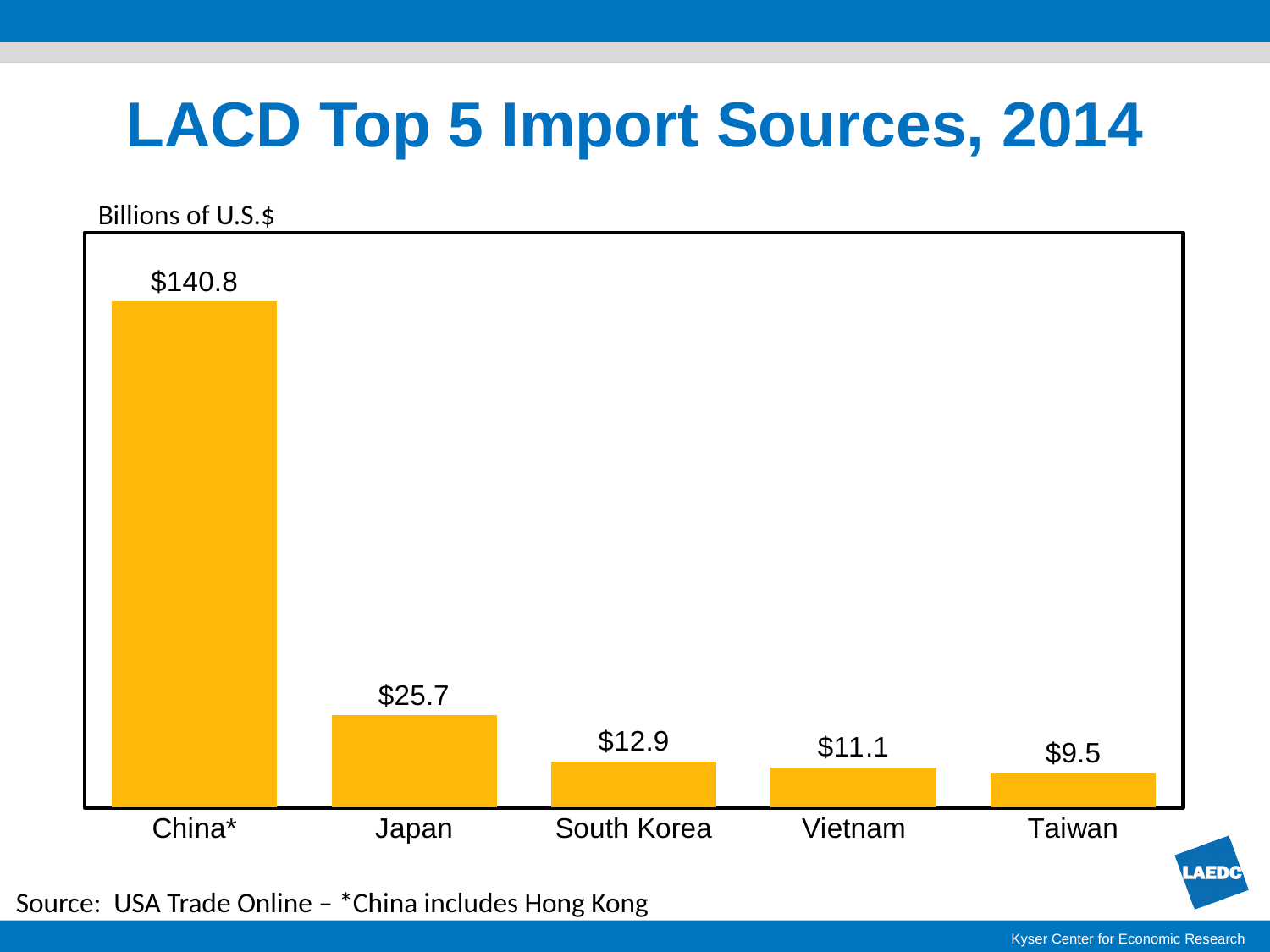
Which import source has the highest value? China* Which is larger, the value for South Korea or the value for Vietnam? South Korea How many import sources are shown in the chart? 5 What unit is the chart measured in, according to the label above the chart? Billions of U.S.$ Which import source has the lowest value? Taiwan What is the import value for Japan? $25.7 What kind of chart is shown on the slide? Bar chart What is the difference between the values for China* and Japan? $115.1 What is the difference between the values for South Korea and Taiwan? $3.4 What is the import value for Vietnam? $11.1 What is the import value for China* in the chart? $140.8 Do the values rise or fall from left to right across the chart? Fall